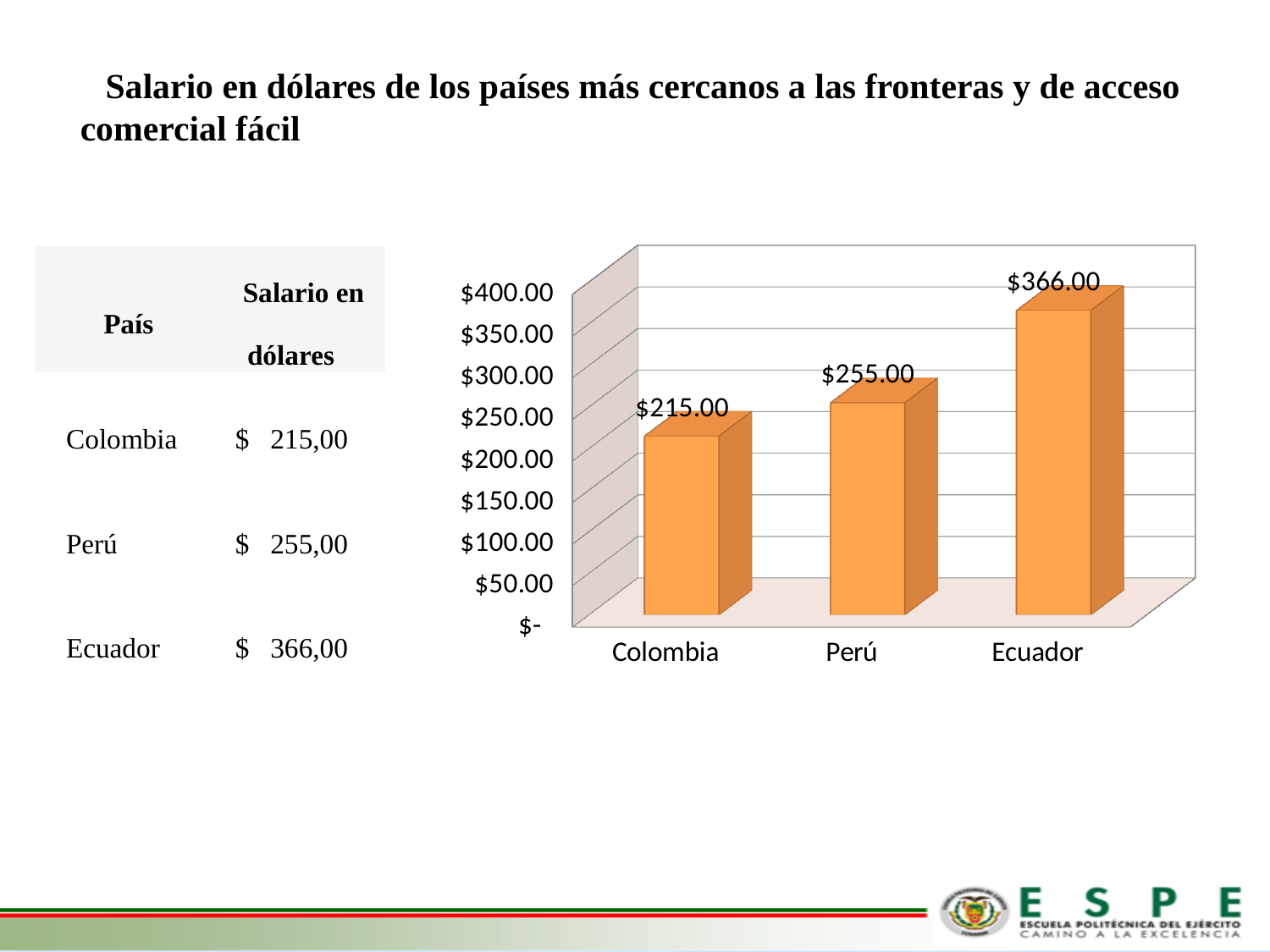
Do the values rise or fall from Colombia to Ecuador along the x axis? Rise What is the value shown for Colombia in the chart? $215.00 What kind of chart is shown on the slide? Bar chart What is the difference between the values for Ecuador and Colombia? $151.00 Which country has the highest value in the chart? Ecuador How many countries are shown in the chart? 3 What is the difference between the values for Perú and Colombia? $40.00 Which is larger, the value for Perú or the value for Colombia? Perú What is the value shown for Ecuador in the chart? $366.00 What is the value shown for Perú in the chart? $255.00 Which country has the lowest value in the chart? Colombia Is the value for Ecuador greater or less than $350.00? greater